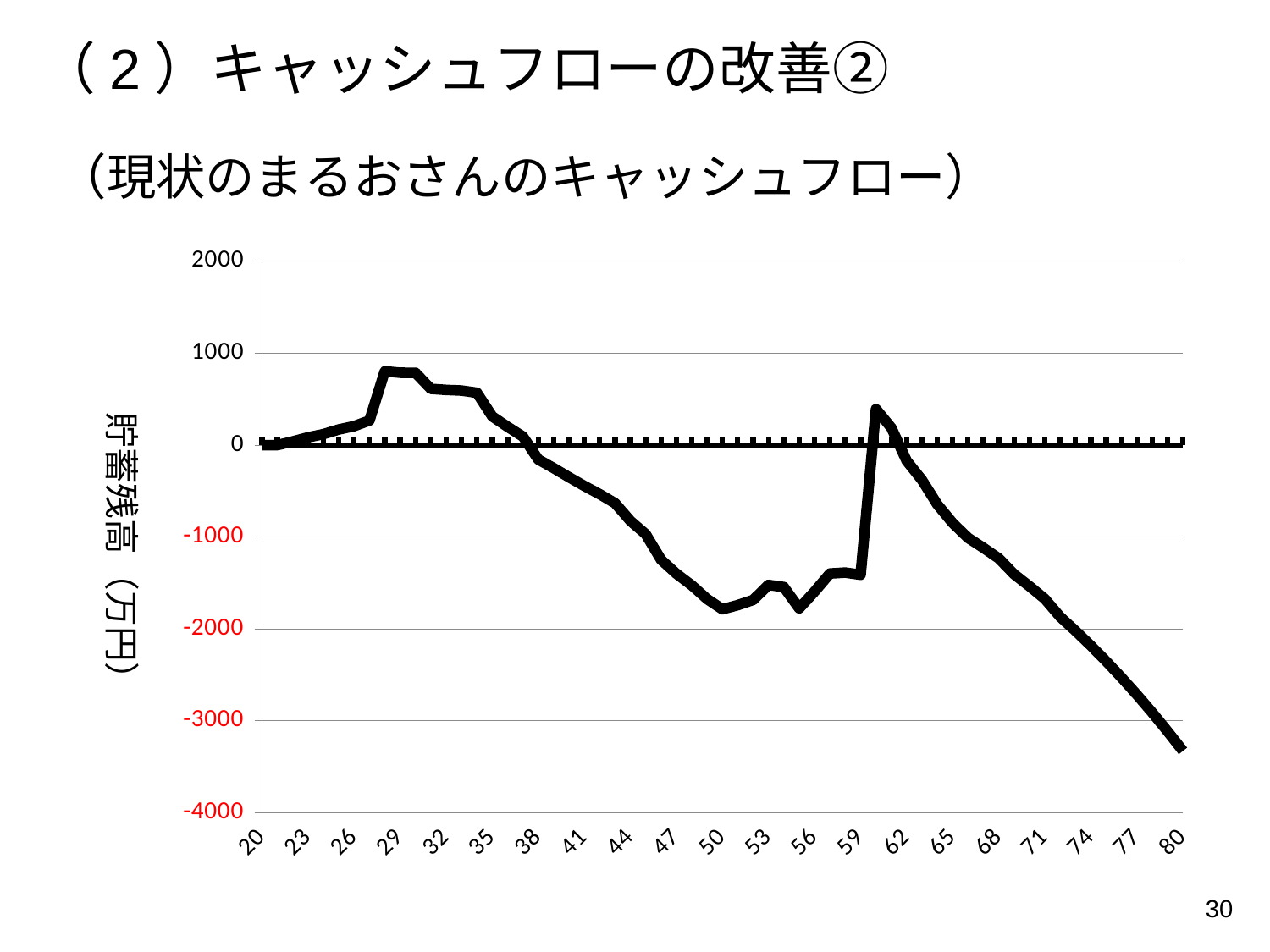
Which is larger, the savings balance at age 29 or at age 50? age 29 Is the savings balance at age 44 greater or less than -1000? greater Does the savings balance rise or fall between age 20 and age 29? rise How many age labels are shown on the x axis? 21 Is the savings balance at age 71 greater or less than -1000? less Is the savings balance at age 50 greater or less than -1000? less What is the label of the vertical axis? 貯蓄残高（万円） What kind of chart is shown on the slide? line chart Does the savings balance rise or fall between age 62 and age 80? fall At which age on the x axis does the savings balance reach its lowest point? 80